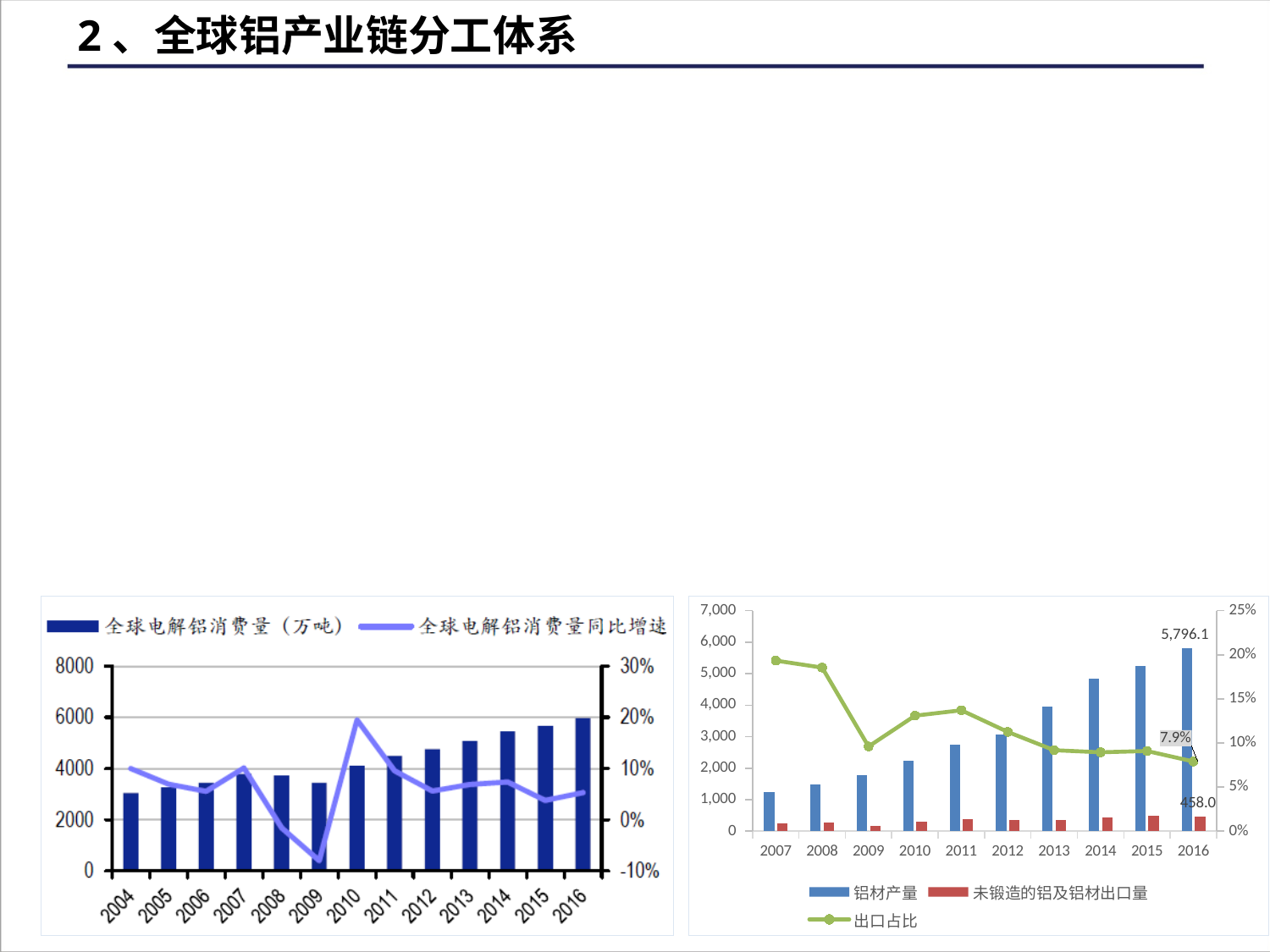
How many years are shown on the x axis of the right chart? 10 How many series does the legend of the left chart list? 2 In the right chart, what is the labelled value of 铝材产量 for 2016? 5,796.1 In the right chart, what is the labelled value of 未锻造的铝及铝材出口量 for 2016? 458.0 In the left chart, which year has the highest 全球电解铝消费量同比增速? 2010 In the left chart, which year has the lowest 全球电解铝消费量同比增速? 2009 How many series does the legend of the right chart list? 3 How many years are shown on the x axis of the left chart? 13 In the right chart, what is the labelled 出口占比 for 2016? 7.9% In the left chart, is the 全球电解铝消费量 bar for 2004 greater or less than 4000? less In the right chart, do the 铝材产量 bars generally rise or fall from 2007 to 2016? rise In the right chart, which year has the lowest 出口占比? 2016